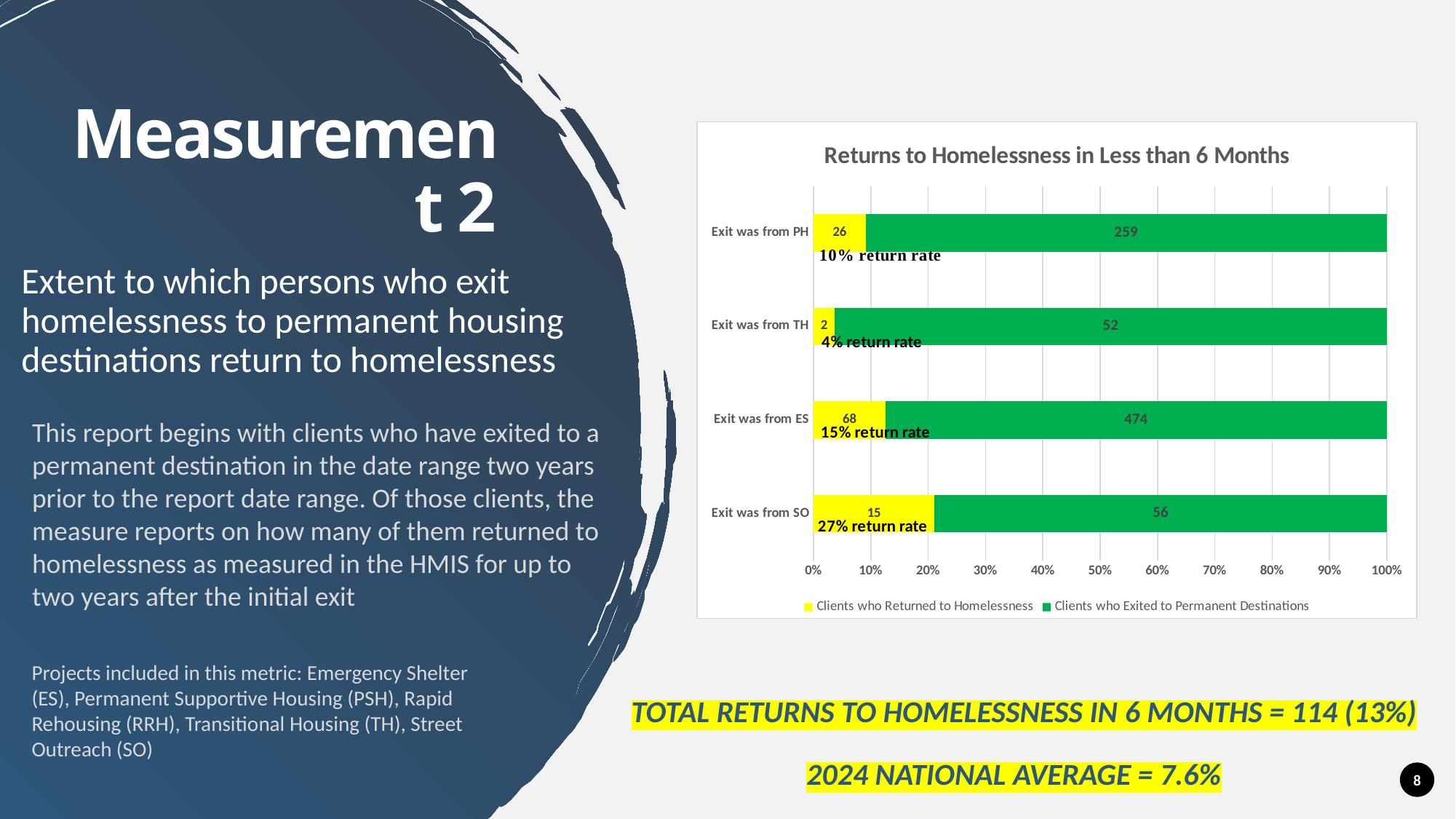
How many series does the chart's legend list? 2 What is the title of the chart? Returns to Homelessness in Less than 6 Months What is the difference between the number of clients who exited to permanent destinations from ES and from PH? 215 How many clients who exited from PH exited to permanent destinations? 259 What is the return rate shown for exits from SO? 27% return rate How many categories are shown on the chart? 4 How many clients who exited from ES returned to homelessness? 68 Which is larger: the number of clients who returned to homelessness from PH or from SO? PH Which exit category has the highest number of clients who returned to homelessness? Exit was from ES Which exit category has the lowest number of clients who returned to homelessness? Exit was from TH What type of chart is shown on the slide? Stacked bar chart What is the total number of clients in the 'Exit was from SO' bar? 71